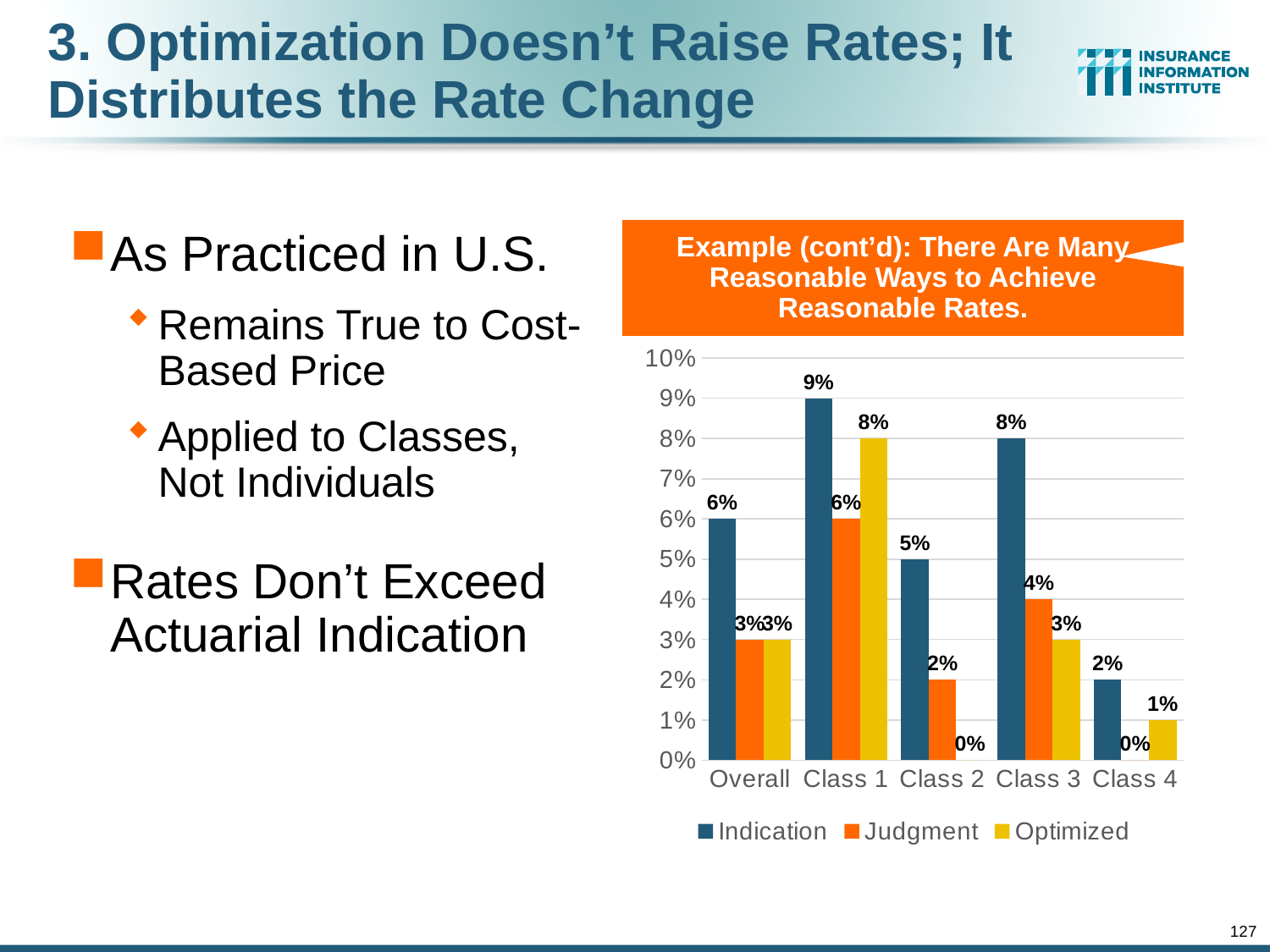
Which category has the highest Indication value? Class 1 Which is larger for Class 3, the Judgment value or the Optimized value? Judgment Which category has the lowest Indication value? Class 4 What is the Indication value for Class 1? 9% What kind of chart is shown on the slide? Bar chart How many series does the legend list? 3 Which series is shown in orange in the legend? Judgment Is the Indication value for Class 3 greater or less than 5%? greater How many categories are shown on the x axis? 5 What is the Judgment value for Class 3? 4% What is the Optimized value for Class 4? 1% What is the difference between the Indication and Judgment values for Class 1? 3%